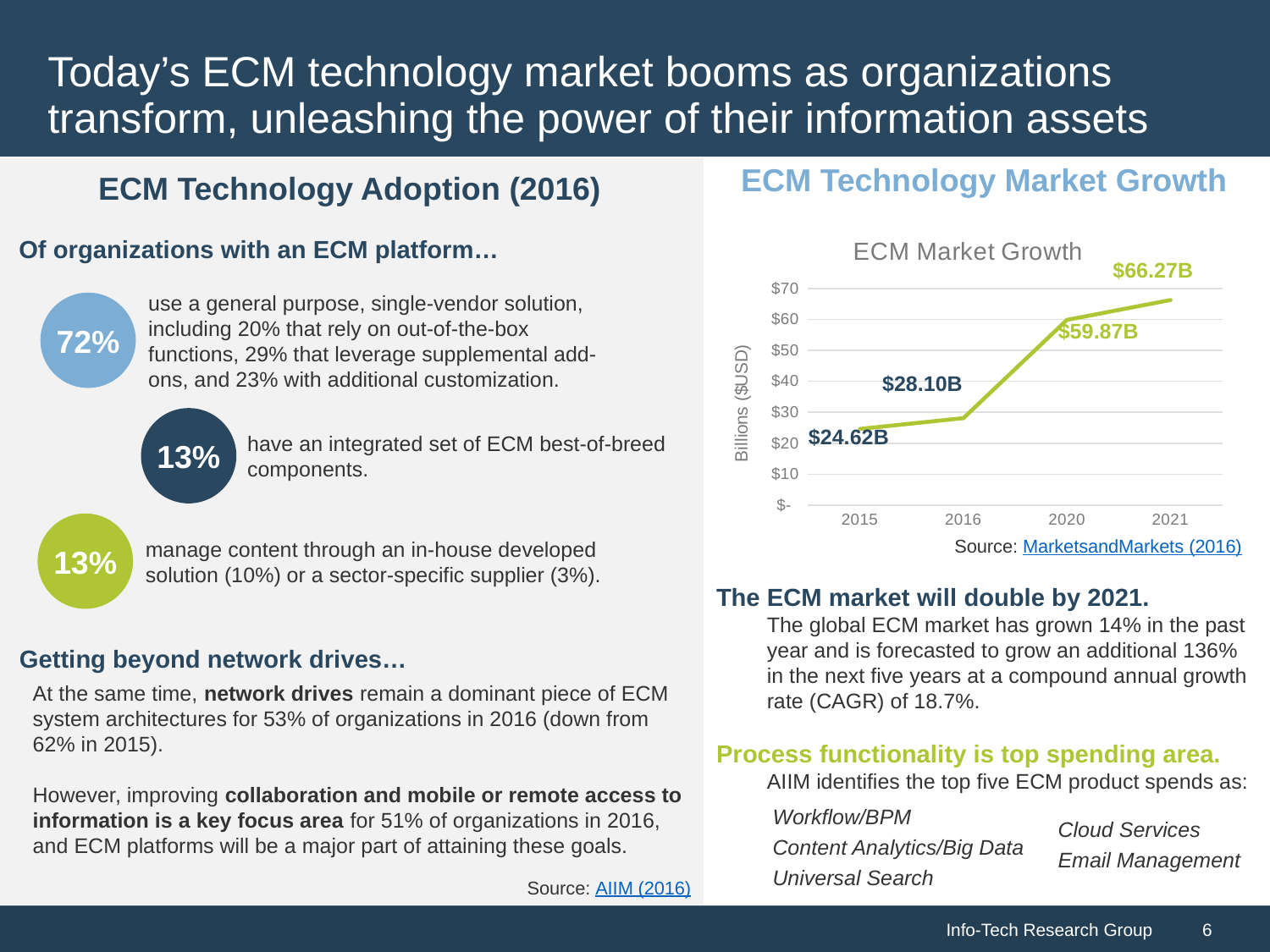
What is the difference between the 2021 and 2020 ECM market values? $6.40B What is the ECM market value shown for 2015? $24.62B Which is larger, the ECM market value for 2016 or for 2020? 2020 Do the values on the ECM Market Growth chart rise or fall from 2015 to 2021? rise Which year has the highest ECM market value on the chart? 2021 Which year has the lowest ECM market value on the chart? 2015 What is the ECM market value shown for 2020? $59.87B What is the ECM market value shown for 2021? $66.27B What type of chart is the ECM Market Growth chart? line chart What is the ECM market value shown for 2016? $28.10B What is the label of the vertical axis on the ECM Market Growth chart? Billions ($USD) How many data points are plotted on the ECM Market Growth chart? 4